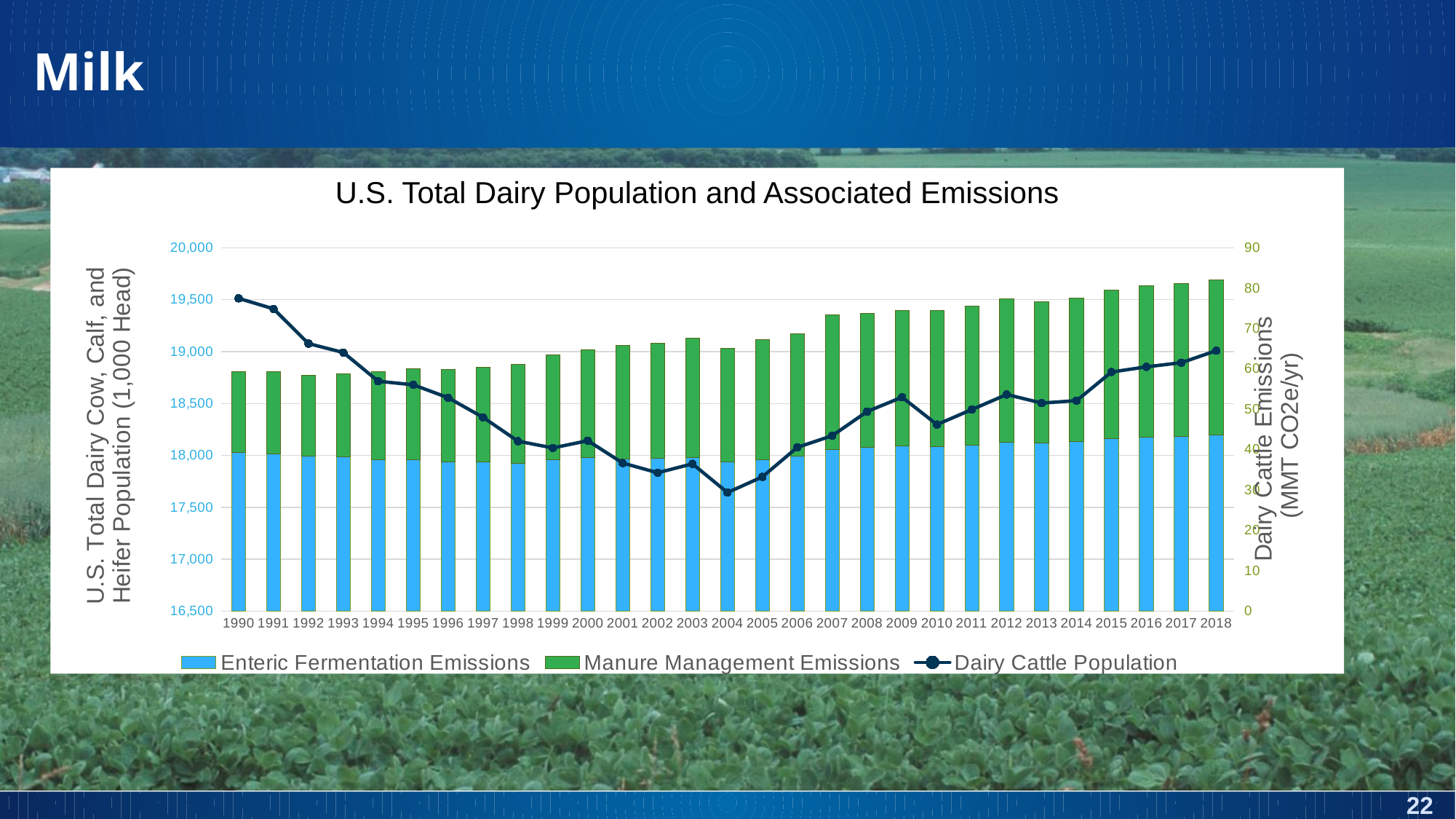
How many series does the chart legend list? 3 Is the stacked bar for 2018 taller or shorter than the stacked bar for 1990? Taller Which year has the tallest stacked bar in the chart? 2018 In which year is the Dairy Cattle Population line at its highest point? 1990 Which series is drawn as a line with markers in the chart? Dairy Cattle Population What is the title of the chart? U.S. Total Dairy Population and Associated Emissions What kind of chart is shown on the slide? A combination chart of stacked bars and a line How many years are shown along the x axis of the chart? 29 Do the stacked bars rise or fall from 2004 to 2018? Rise Does the Dairy Cattle Population line rise or fall from 1990 to 2004? Fall In which year does the Dairy Cattle Population line reach its lowest point? 2004